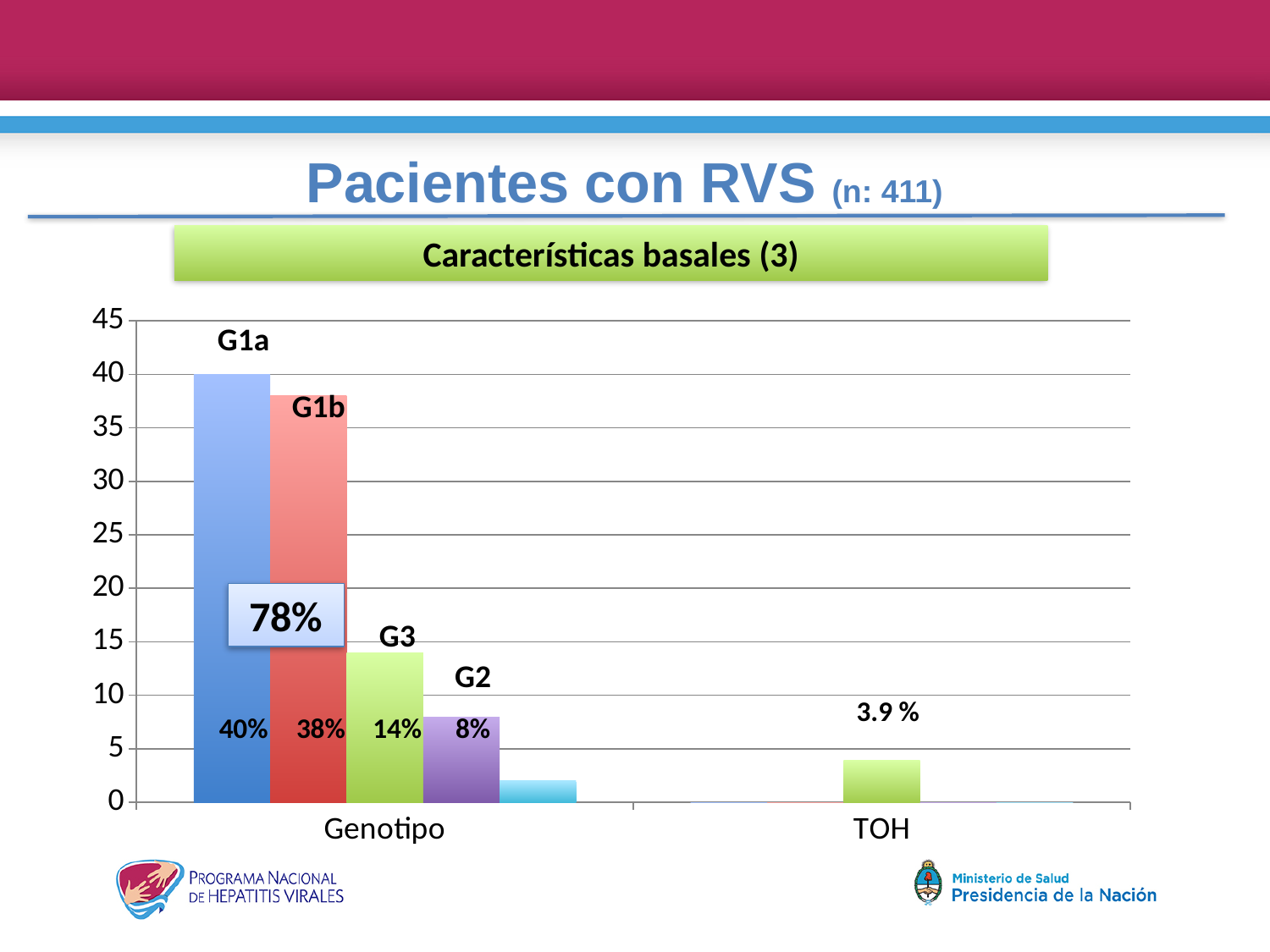
Which is larger, the value for G3 or the value for G2? G3 What is the value shown for genotype G1b? 38% What value is labeled above the bar in the TOH category? 3.9 % What is the difference in percentage points between G1a (40%) and G1b (38%)? 2 Among the labeled genotypes G1a, G1b, G3 and G2, which has the lowest value? G2 Which genotype has the highest value in the Genotipo category? G1a What is the value shown for genotype G3? 14% What combined percentage is shown for G1a and G1b together? 78% Is the value of the unlabeled light blue bar in the Genotipo category greater or less than 5? less What is the value shown for genotype G2? 8% What type of chart is shown on the slide? bar chart What is the value shown for genotype G1a? 40%